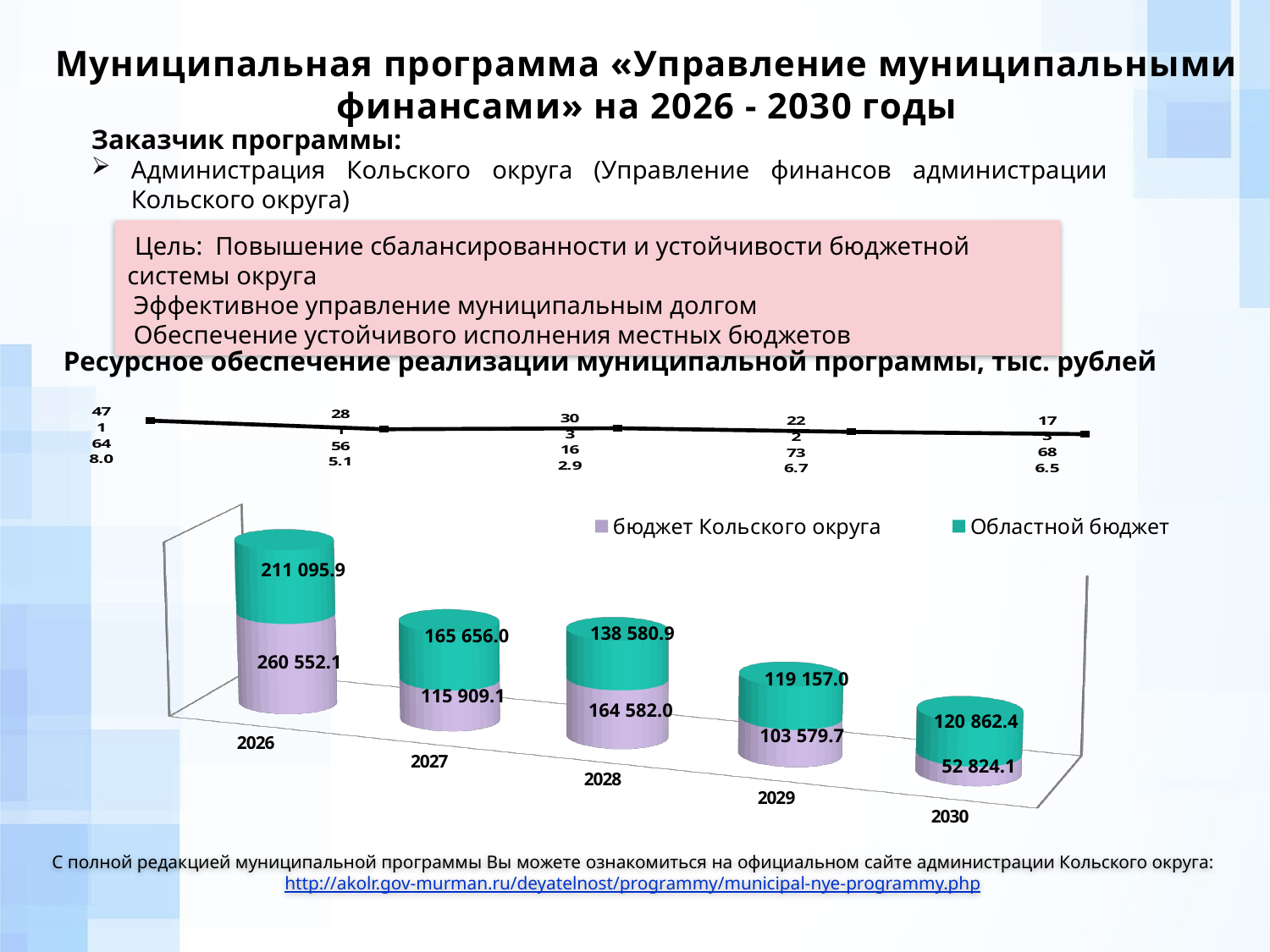
In 2028, which is larger: бюджет Кольского округа or Областной бюджет? бюджет Кольского округа What is the total of the stacked bar for 2030? 173 686.5 What is the difference between бюджет Кольского округа and Областной бюджет in 2026? 49 456.2 In which year is the Областной бюджет value the highest? 2026 What kind of chart is used to show the resource provision by year? Stacked bar chart What is the value for бюджет Кольского округа in 2028? 164 582.0 What is the value for Областной бюджет in 2026? 211 095.9 How many years are shown on the x axis of the chart? 5 What is the value for бюджет Кольского округа in 2030? 52 824.1 In which year is the бюджет Кольского округа value the lowest? 2030 How many series does the legend list? 2 What is the value for Областной бюджет in 2029? 119 157.0